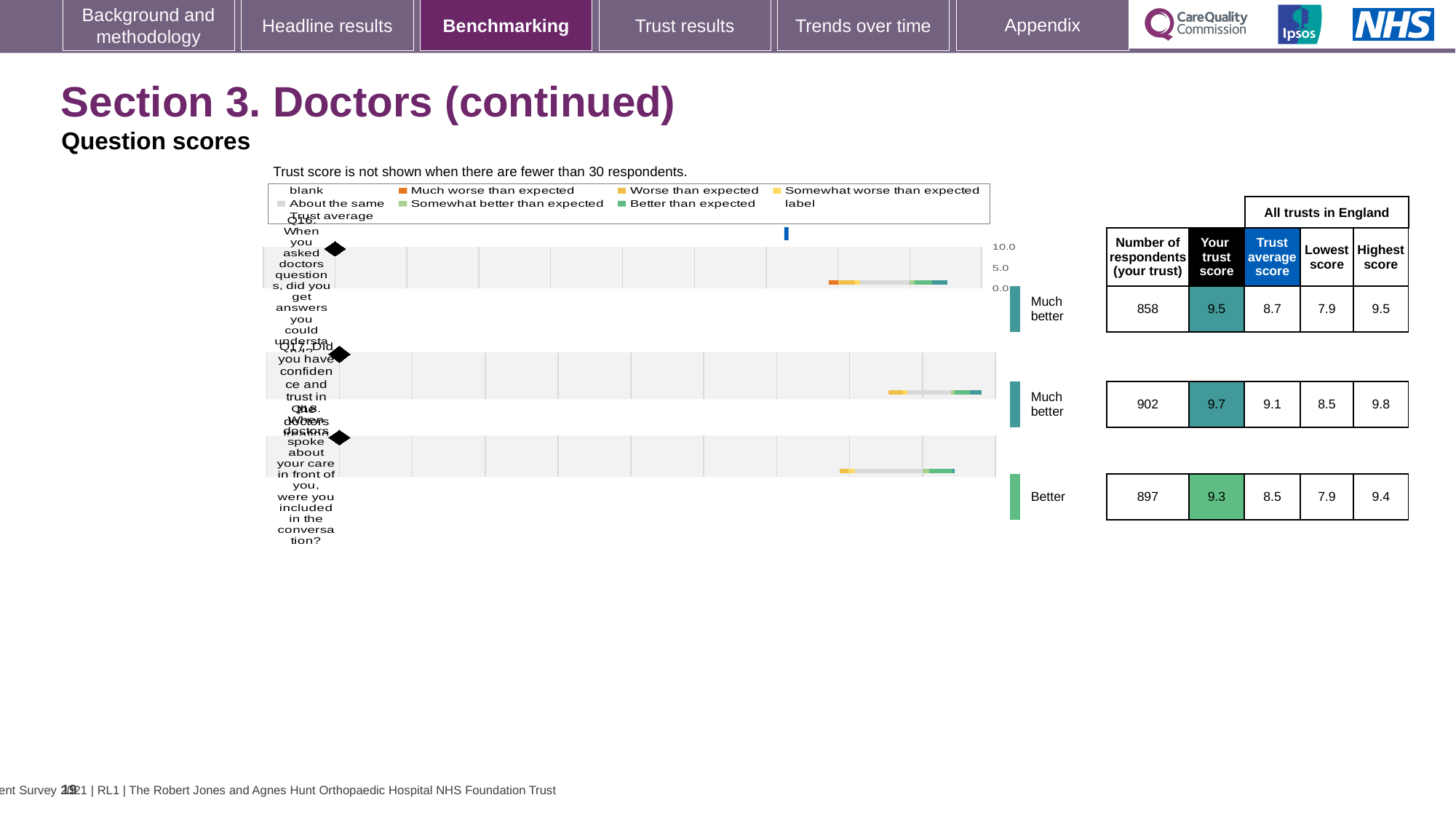
What benchmark category label is shown next to Q18? Better What is the 'Your trust score' for Q17 (Did you have confidence and trust in the doctors treating you?)? 9.7 What is the 'Lowest score' across all trusts in England for Q18? 7.9 How many respondents (your trust) are shown for Q16? 858 Which legend entry is shown with the orange colour? Much worse than expected Which question has the highest 'Your trust score'? Q17 How many questions (Q16, Q17, Q18) are plotted in the chart? 3 What is the 'Highest score' across all trusts in England for Q17? 9.8 Which question has the lowest 'Your trust score'? Q18 What kind of chart is used to show the question scores on this slide? bar chart For Q16, which is larger: the 'Your trust score' or the 'Trust average score'? Your trust score What is the difference between the 'Your trust score' and the 'Trust average score' for Q17? 0.6